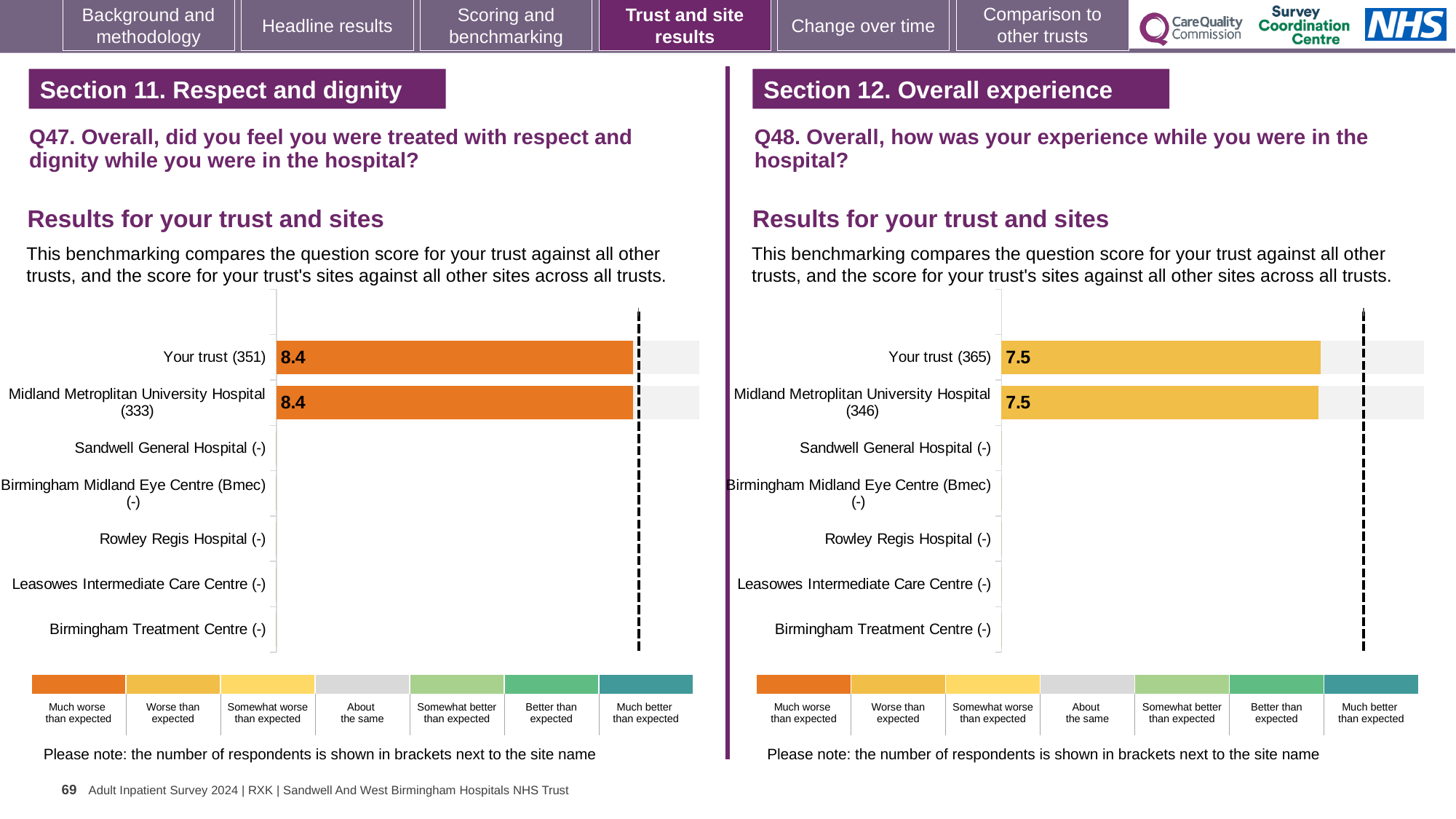
On the Q47 chart (left), what is the score for Midland Metroplitan University Hospital? 8.4 Is the score for Your trust on the Q47 chart (left) larger or smaller than the score for Your trust on the Q48 chart (right)? larger What kind of chart is used on the Q47 chart (left)? bar chart On the Q47 chart (left), what is the difference between the score for Your trust and the score for Midland Metroplitan University Hospital? 0 On the Q48 chart (right), what is the score for Midland Metroplitan University Hospital? 7.5 On the Q47 chart (left), how many respondents are shown in brackets for Your trust? 351 On the Q47 chart (left), what is the score for Your trust? 8.4 How many site categories are listed on the Q48 chart (right)? 7 On the Q48 chart (right), what is the score for Your trust? 7.5 On the Q48 chart (right), which benchmark category does the colour of the Your trust bar correspond to in the legend? Worse than expected On the Q48 chart (right), how many respondents are shown in brackets for Midland Metroplitan University Hospital? 346 On the Q47 chart (left), which benchmark category does the colour of the Your trust bar correspond to in the legend? Much worse than expected